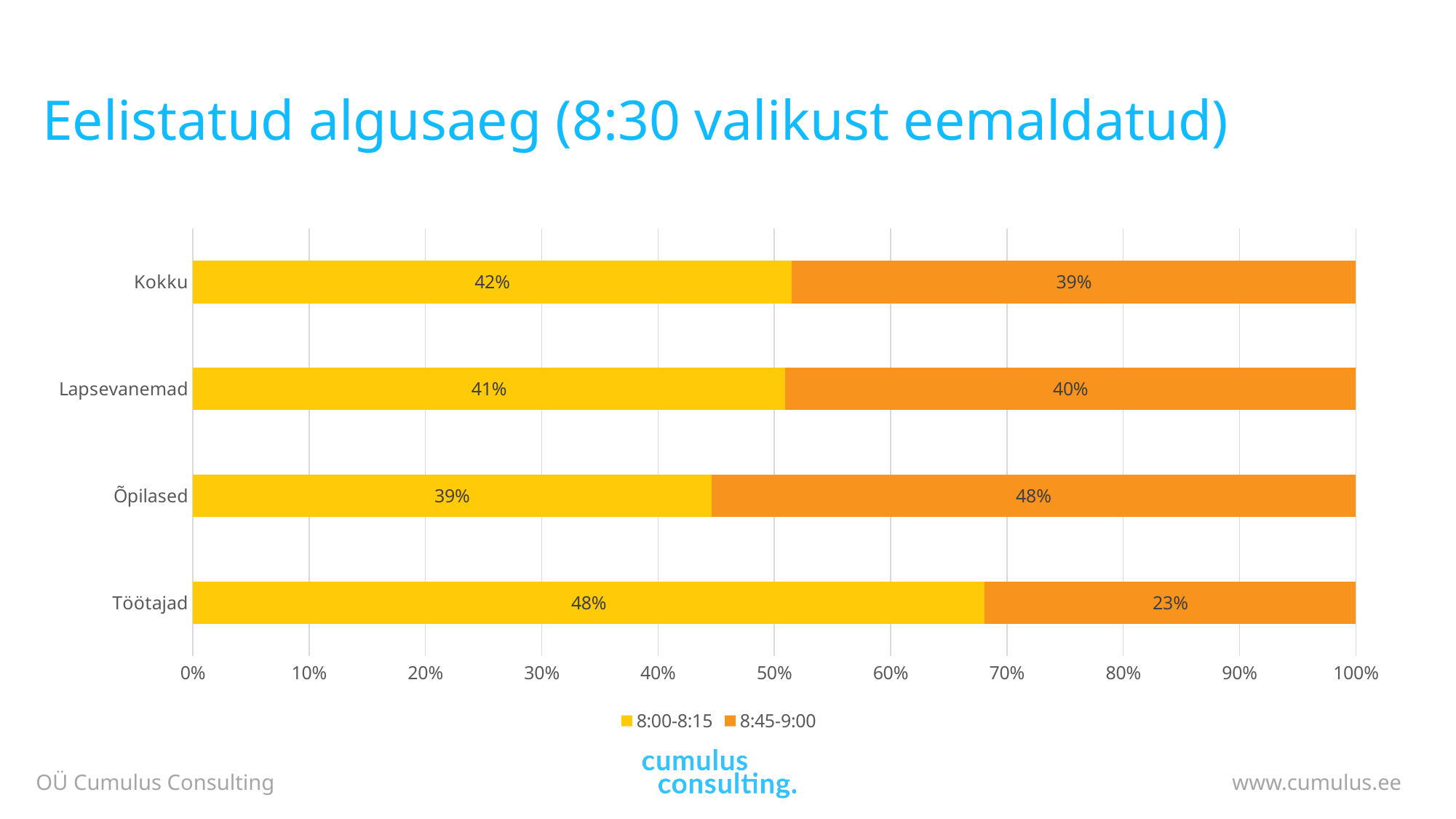
What is the value for 8:45-9:00 for Lapsevanemad? 40% What is the difference between the 8:00-8:15 and 8:45-9:00 values for Töötajad? 25% What is the title of the chart? Eelistatud algusaeg (8:30 valikust eemaldatud) Which category has the lowest value for 8:45-9:00? Töötajad What is the value for 8:00-8:15 for Töötajad? 48% How many categories are shown on the chart? 4 How many series does the legend list? 2 What is the value for 8:45-9:00 for Õpilased? 48% What is the value for 8:00-8:15 for Kokku? 42% Which is larger for Õpilased: the 8:00-8:15 value or the 8:45-9:00 value? 8:45-9:00 What kind of chart is shown on the slide? bar chart Which category has the highest value for 8:00-8:15? Töötajad